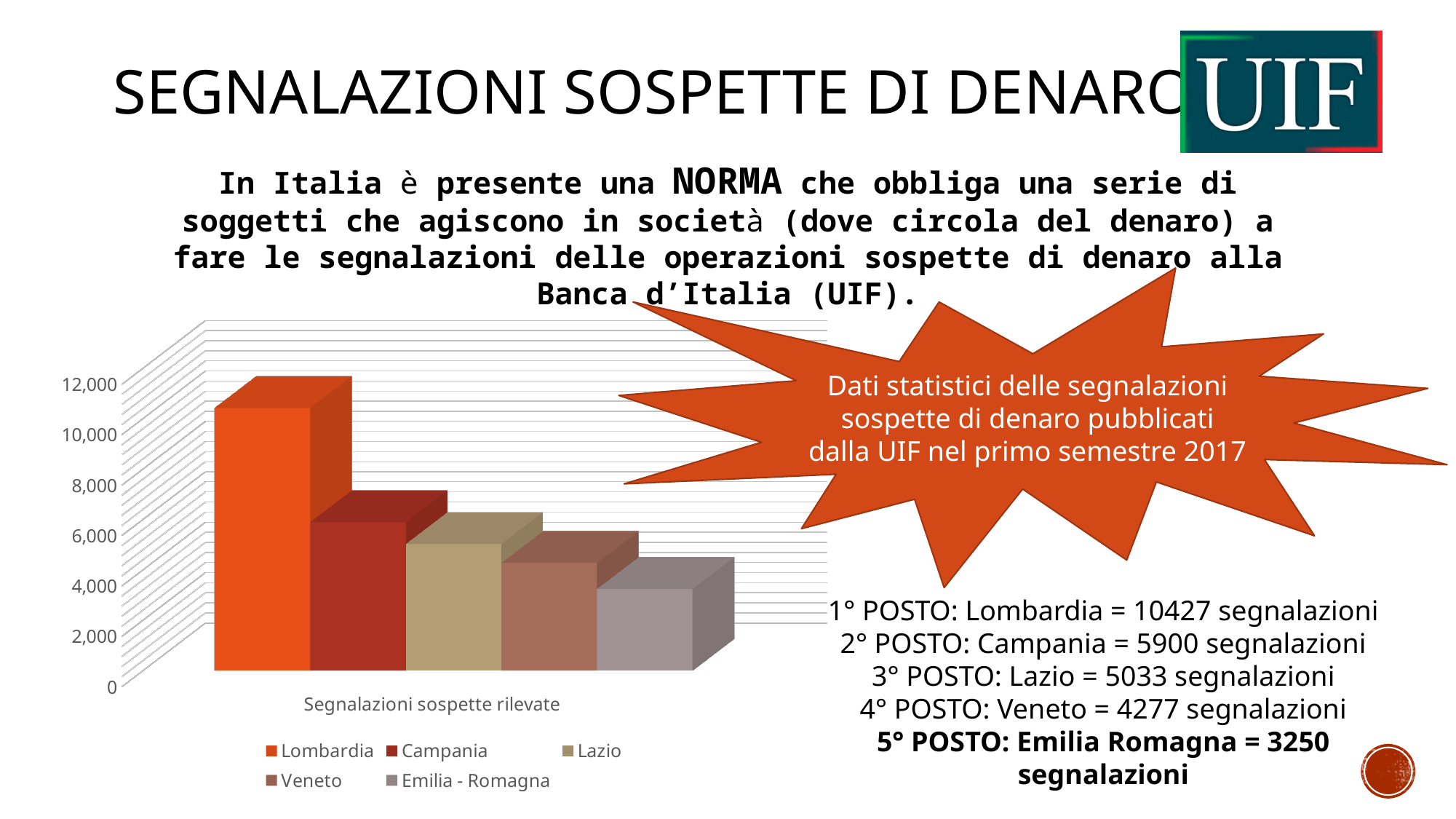
What is the category label shown under the bars on the x axis? Segnalazioni sospette rilevate How many series does the chart legend list? 5 Which region has the lowest bar in the chart? Emilia - Romagna According to the slide, how many segnalazioni does Lazio have? 5033 Which bar is taller, Campania or Lazio? Campania Is the value for Emilia - Romagna greater or less than 4,000? less Which region has the highest bar in the chart? Lombardia What is the difference between the segnalazioni for Campania and Veneto, as listed on the slide? 1623 According to the slide, how many segnalazioni does Lombardia have? 10427 Is the value for Lombardia greater or less than 10,000? greater Is the value for Veneto greater or less than 4,000? greater What kind of chart is shown on the slide? bar chart